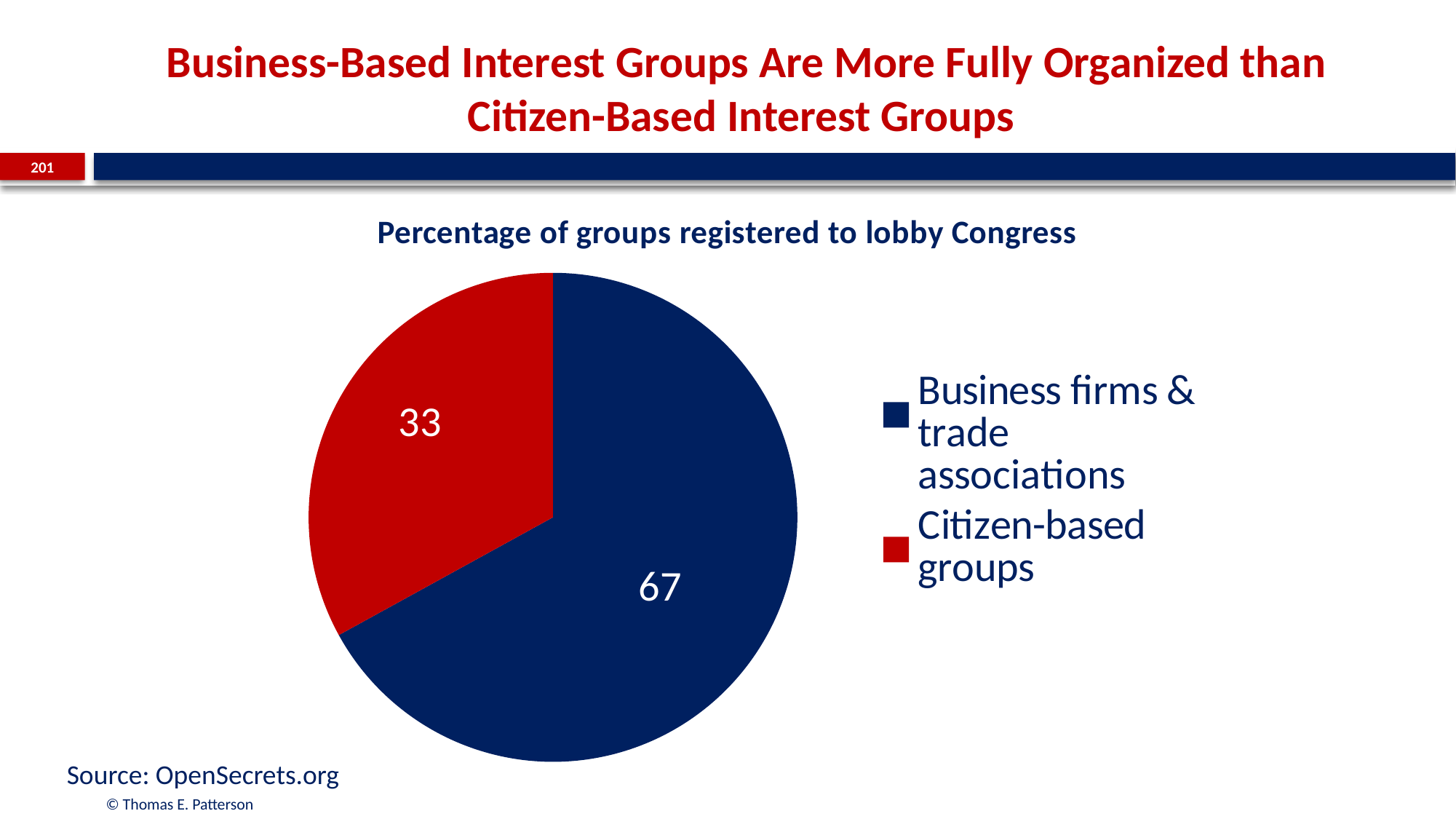
What is the title of the chart? Percentage of groups registered to lobby Congress What colour is the slice for Citizen-based groups? Red What value is shown for Business firms & trade associations? 67 What share of the pie does the Citizen-based groups slice represent? 33% What value is shown for Citizen-based groups? 33 How many categories does the pie chart show? 2 What is the difference between the values for Business firms & trade associations and Citizen-based groups? 34 Which category has the smallest slice of the pie? Citizen-based groups Which category has the largest slice of the pie? Business firms & trade associations What kind of chart is shown on the slide? Pie chart Which is larger, the value for Business firms & trade associations or the value for Citizen-based groups? Business firms & trade associations